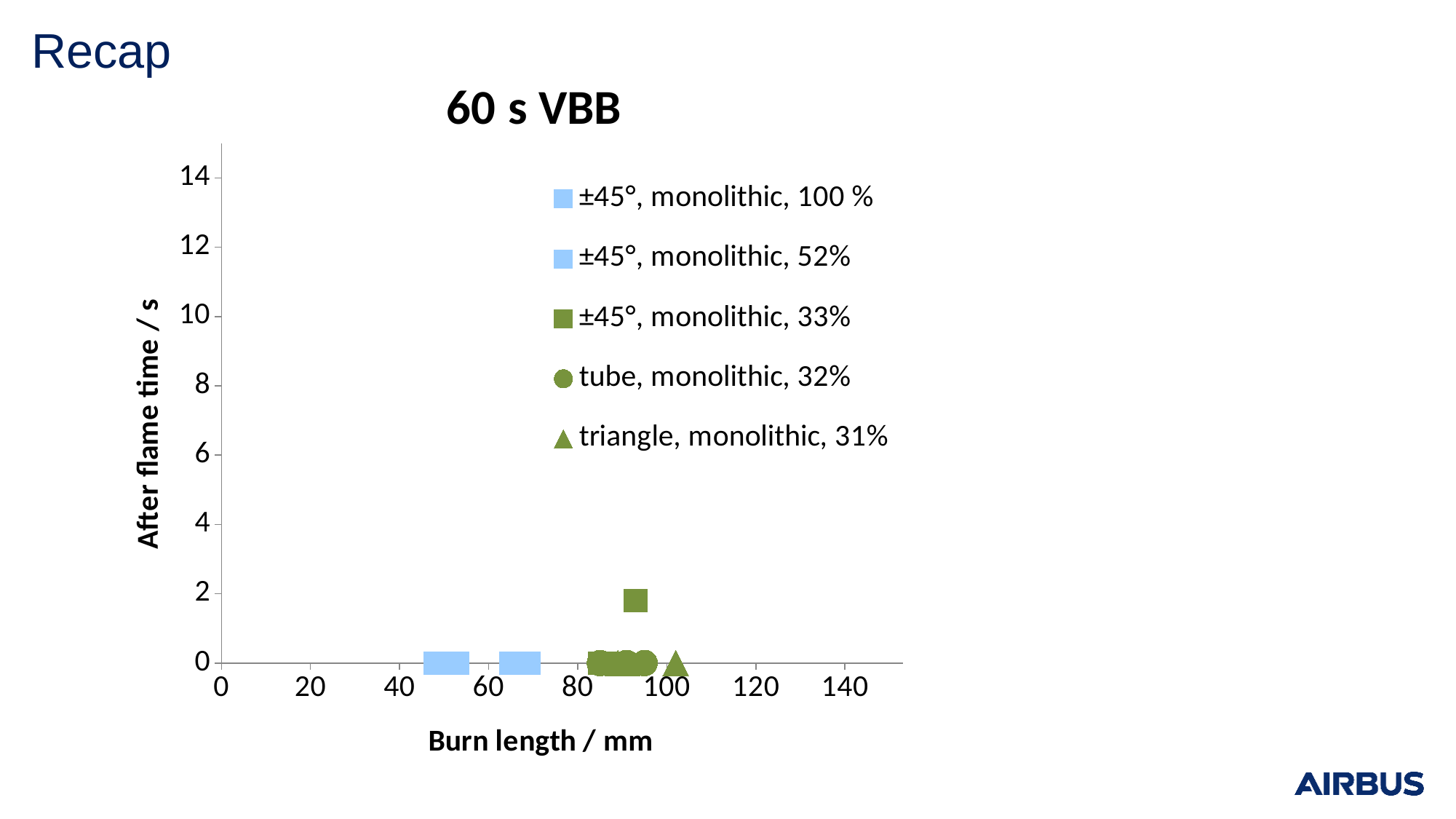
Which has the larger burn length: the triangle, monolithic, 31% point or the ±45°, monolithic, 100 % points? triangle, monolithic, 31% What is the highest value shown on the y axis? 14 What is the title of the chart? 60 s VBB Is the burn length of the triangle, monolithic, 31% point greater or less than 120 mm? less What kind of chart is shown on the slide? scatter chart What is the label of the x axis? Burn length / mm How many series does the legend list? 5 Is the burn length of the triangle, monolithic, 31% point greater or less than 80 mm? greater Is the after flame time of the highest point in the chart greater or less than 4 s? less Which series has the point with the highest after flame time? ±45°, monolithic, 33%